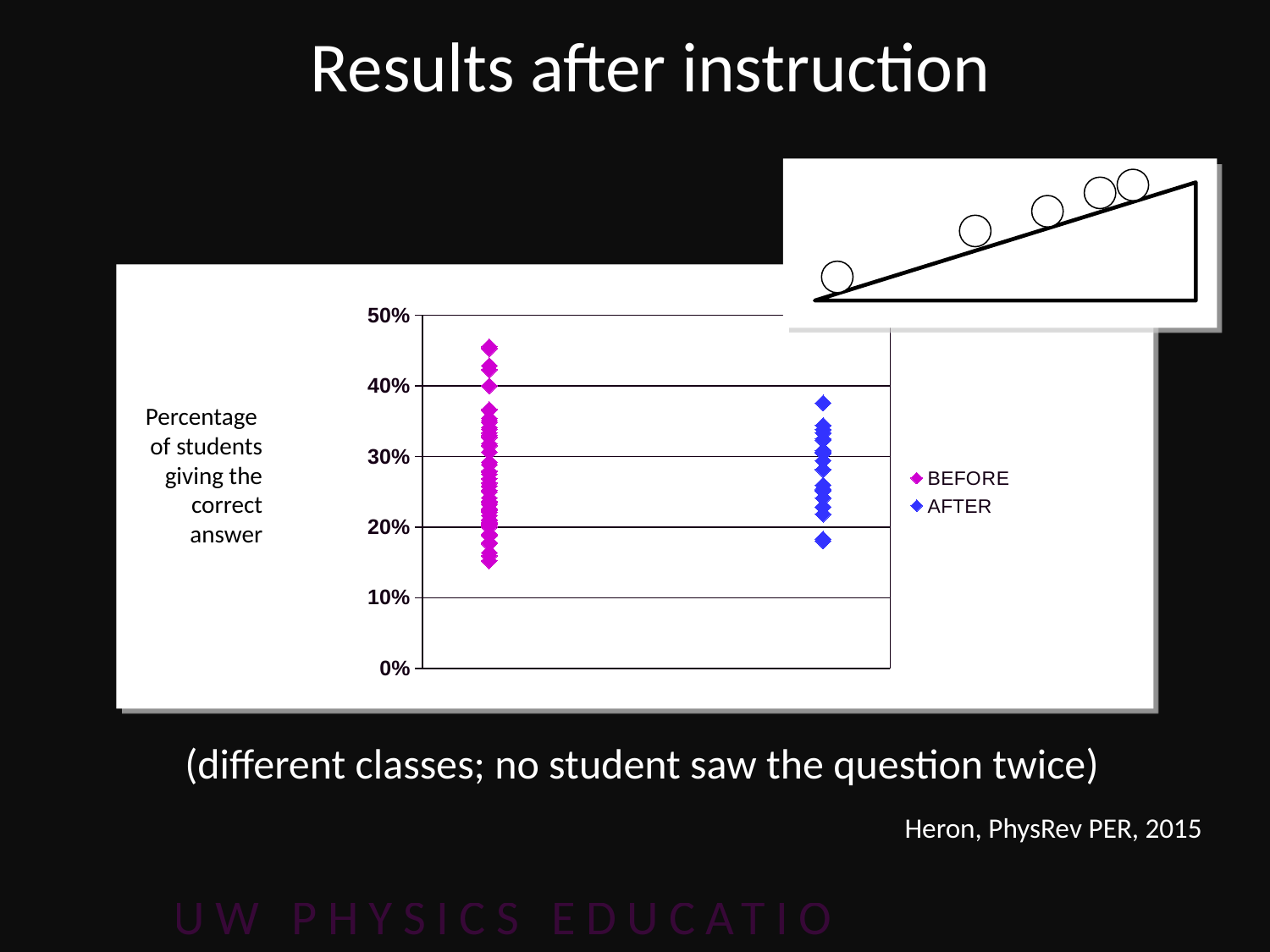
Which colour is used for the AFTER series in the chart? blue What are the two series named in the chart legend? BEFORE and AFTER How many series does the chart legend list? 2 Is the lowest BEFORE point in the chart greater or less than 10%? greater What kind of chart is shown on the slide? scatter chart Is the highest AFTER point in the chart greater or less than 40%? less Is the lowest AFTER point in the chart greater or less than 20%? less What is the highest value shown on the chart's vertical axis? 50% Which series contains the single highest point in the chart, BEFORE or AFTER? BEFORE